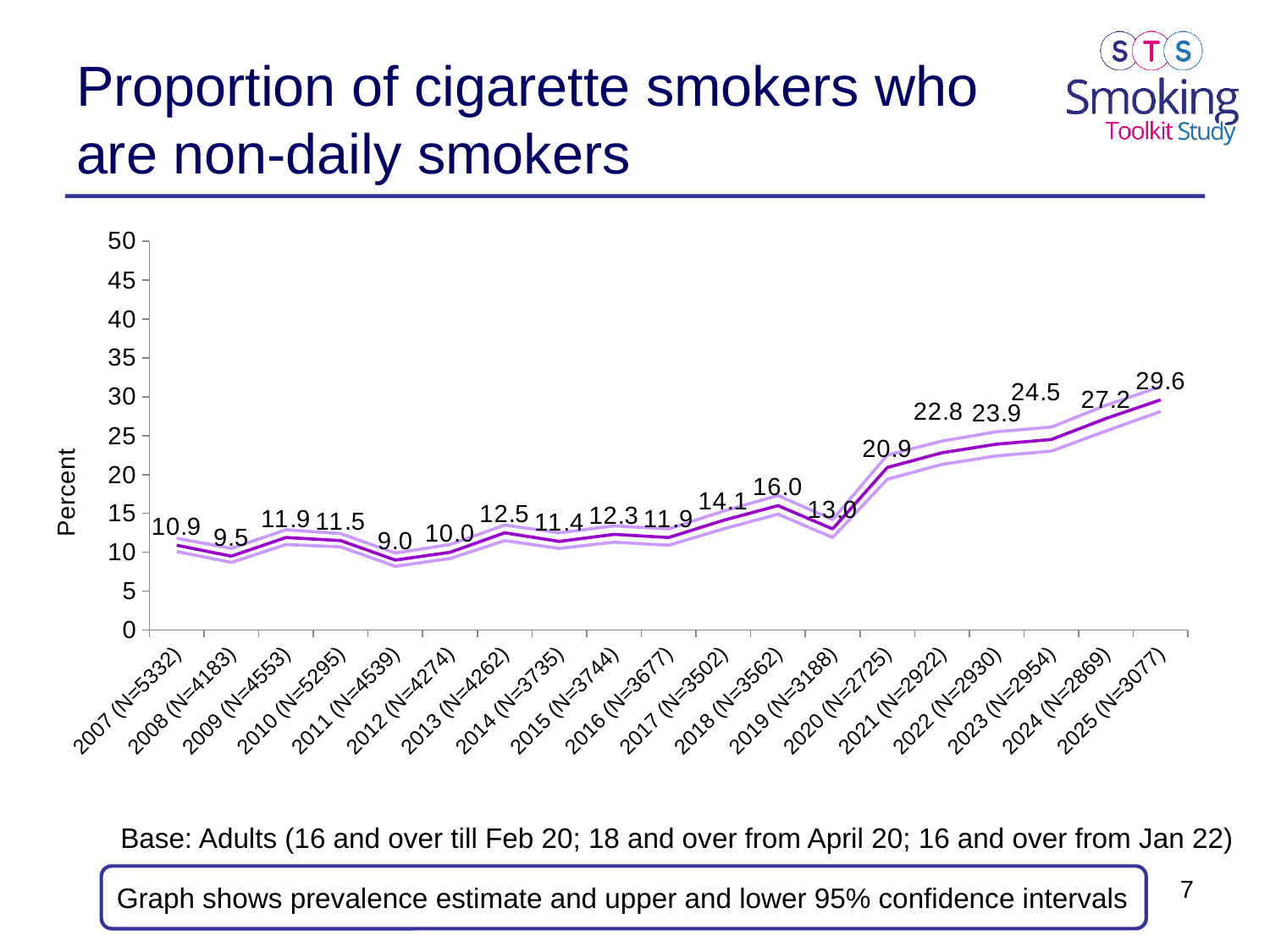
Is the value for 2024 (N=2869) greater or less than 25? greater What is the value for 2020 (N=2725)? 20.9 Which year has the lowest value? 2011 (N=4539) What is the difference between the values for 2025 (N=3077) and 2007 (N=5332)? 18.7 Do the values generally rise or fall from 2019 (N=3188) to 2025 (N=3077)? Rise What is the value for 2025 (N=3077)? 29.6 Which year has the highest value? 2025 (N=3077) How many years are plotted on the x axis? 19 What is the value for 2011 (N=4539)? 9.0 What is the label on the y axis? Percent What kind of chart is shown on the slide? Line chart Which is larger, the value for 2018 (N=3562) or the value for 2019 (N=3188)? 2018 (N=3562)